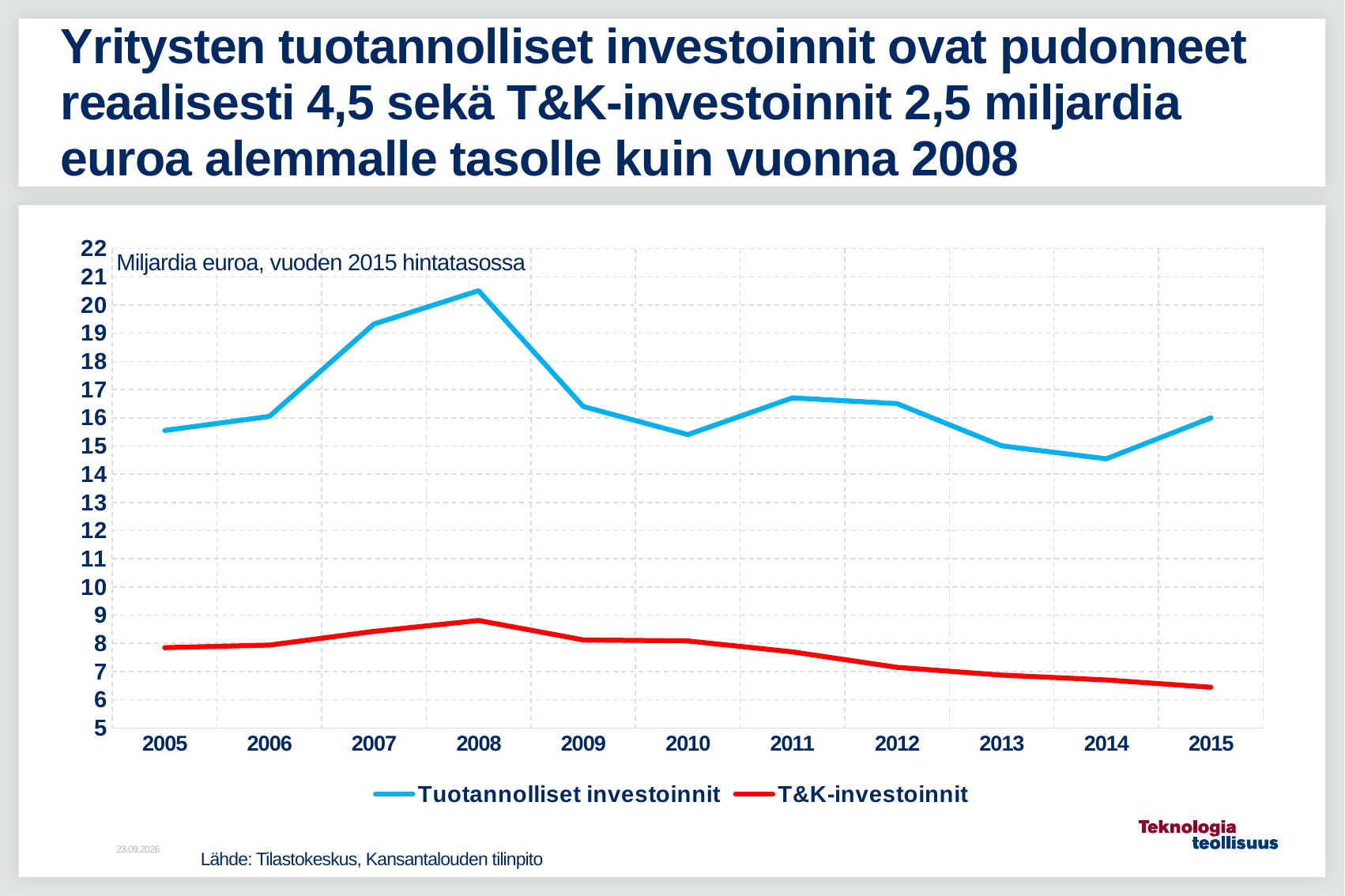
How many series does the legend list? 2 In which year does the Tuotannolliset investoinnit line reach its highest value? 2008 Which series has the larger value in 2010, Tuotannolliset investoinnit or T&K-investoinnit? Tuotannolliset investoinnit Does the T&K-investoinnit line rise or fall from 2008 to 2015? fall How many years are plotted along the x axis? 11 Is the value of T&K-investoinnit in 2015 greater or less than 7? less Is the value of T&K-investoinnit in 2008 greater or less than 8? greater Is the value of Tuotannolliset investoinnit in 2008 greater or less than 20? greater What unit note is printed at the top of the chart area? Miljardia euroa, vuoden 2015 hintatasossa What colour is the T&K-investoinnit line? red What kind of chart is shown on the slide? line chart